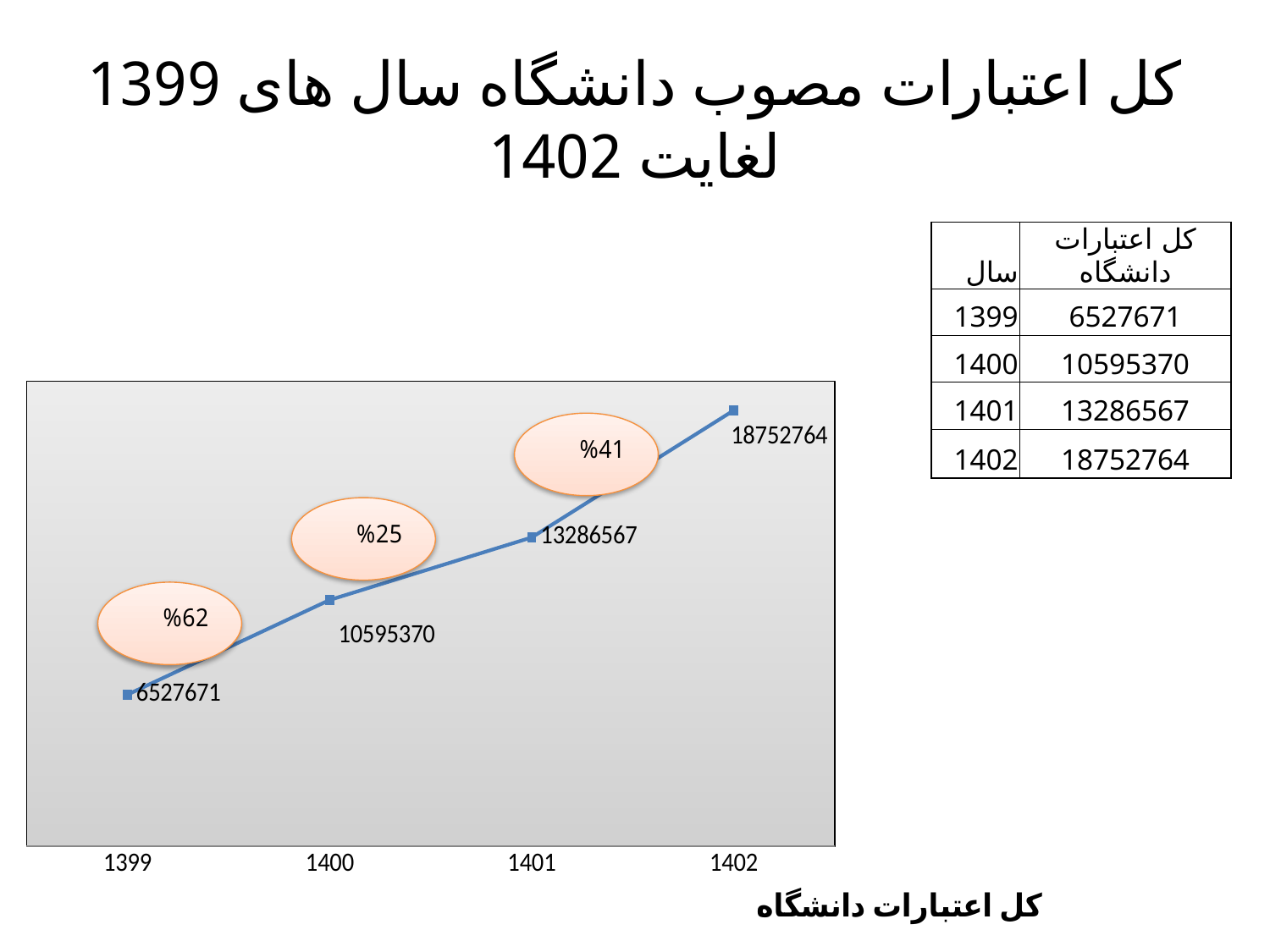
What is the value plotted for 1401? 13286567 What is the value plotted for 1399? 6527671 Which year has the highest value? 1402 What is the value plotted for 1402? 18752764 What is the difference between the values for 1400 and 1399? 4067699 Which is larger, the value for 1401 or the value for 1400? 1401 Which year has the lowest value? 1399 What is the value plotted for 1400? 10595370 What kind of chart is shown? line chart What is the difference between the values for 1402 and 1401? 5466197 Do the values rise or fall from 1399 to 1402? rise How many years are plotted on the chart? 4